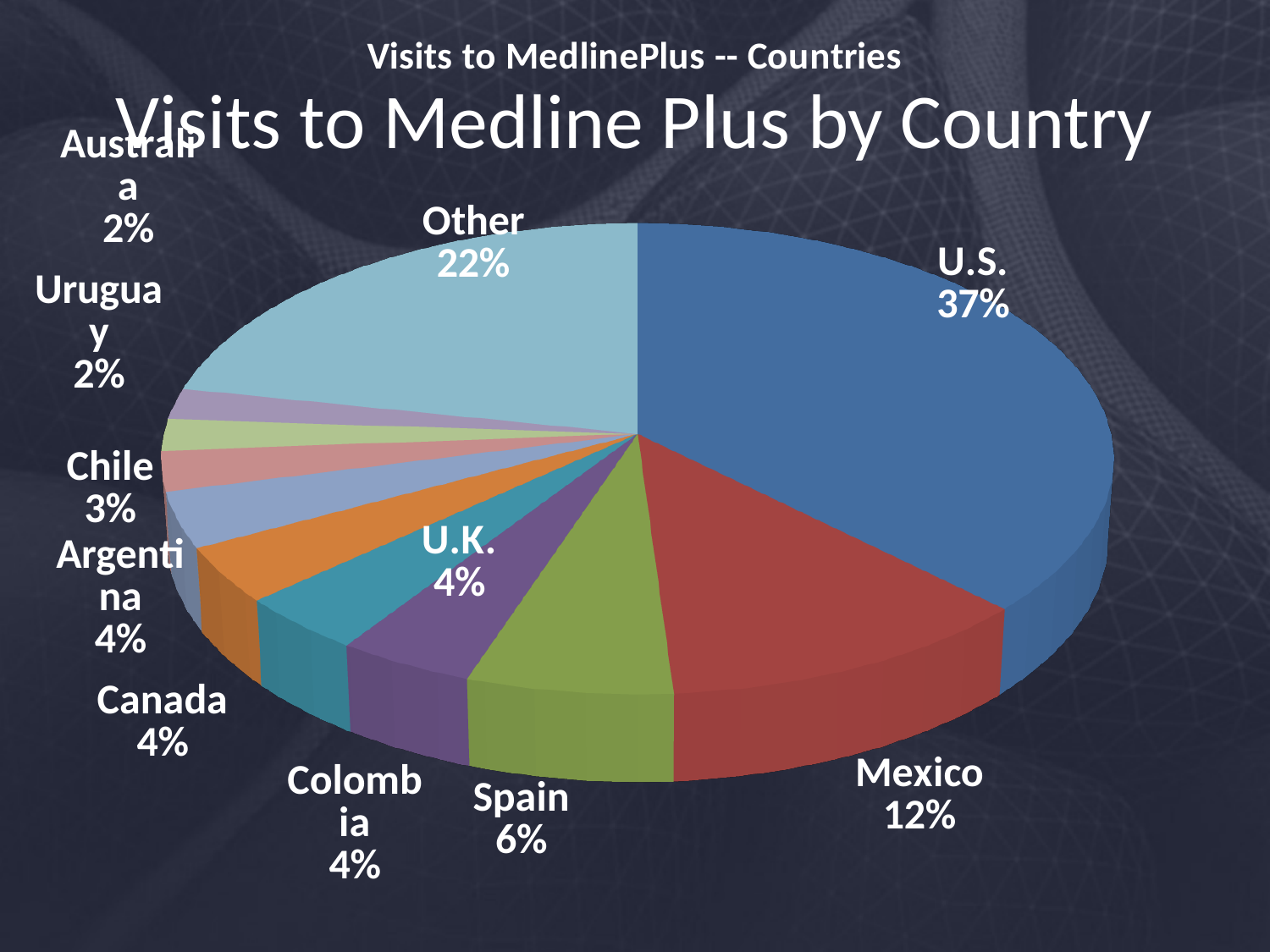
What share of visits to MedlinePlus comes from the U.S.? 37% What is the difference in percentage points between the U.S. share and the Mexico share? 25 What type of chart is shown on the slide? Pie chart What share of visits comes from Chile? 3% What is the difference in percentage points between the Other slice and the Spain slice? 16 Which of the two has a larger share of visits, Mexico or Spain? Mexico What percentage of visits comes from Spain? 6% How many slices does the pie chart have? 11 What percentage of visits is attributed to Mexico? 12% What is the title of the chart? Visits to MedlinePlus -- Countries Which country has the largest share of visits to MedlinePlus? U.S. What share of visits does the Other slice represent? 22%